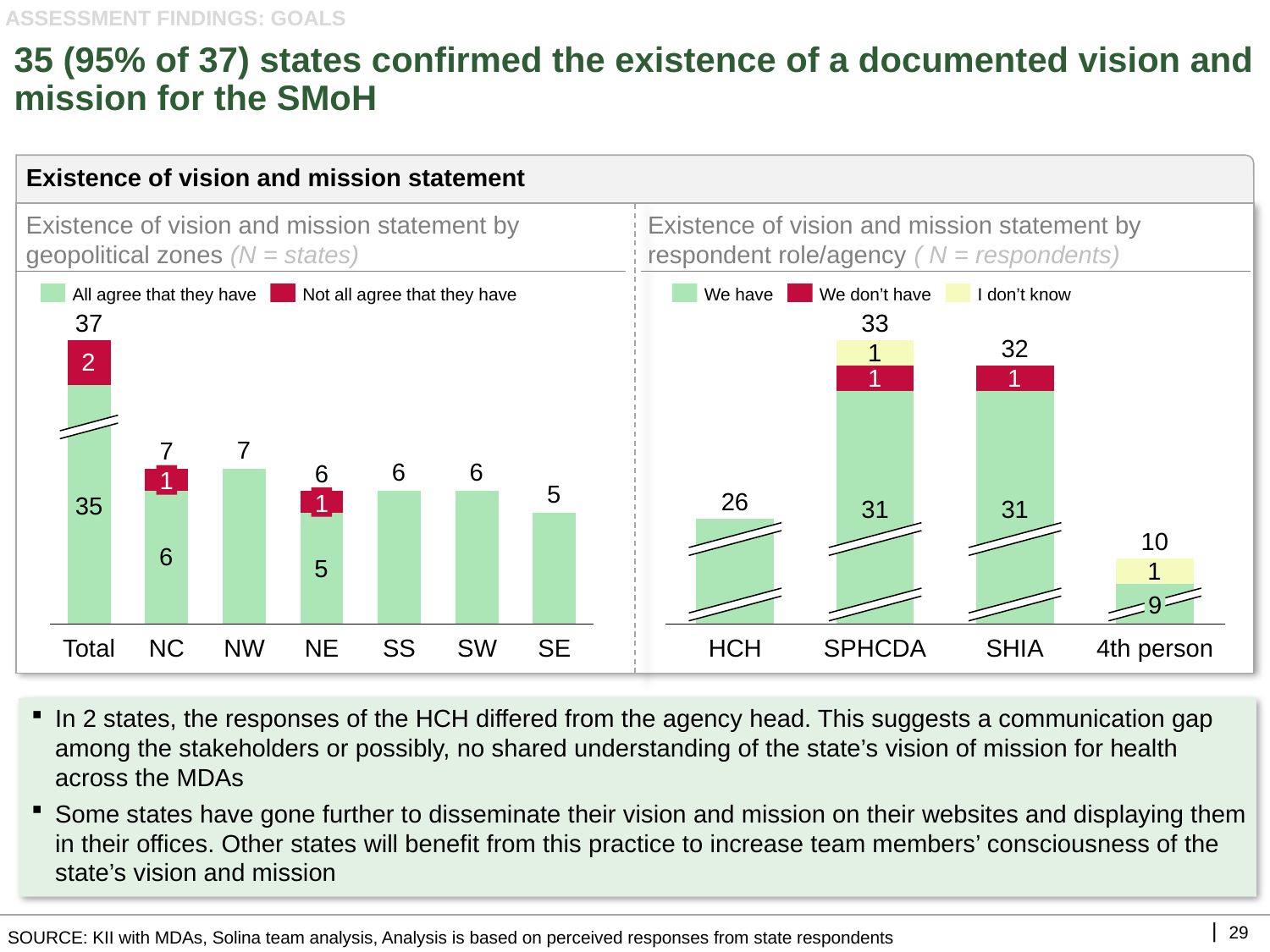
In the chart by geopolitical zones, what is the total value for the Total bar? 37 In the chart by respondent role/agency, which category has the lowest total? 4th person In the chart by respondent role/agency, how many categories are shown on the x axis? 4 In the chart by respondent role/agency, what is the 'We have' value for SHIA? 31 In the chart by geopolitical zones, what is the 'All agree that they have' value for NE? 5 In the chart by respondent role/agency, what is the total value for SPHCDA? 33 In the chart by geopolitical zones, which zone (excluding Total) has the lowest total? SE In the chart by respondent role/agency, which category has the highest total? SPHCDA In the chart by geopolitical zones, what is the 'Not all agree that they have' value for NC? 1 What kind of chart is the chart by respondent role/agency? Stacked bar chart In the chart by geopolitical zones, how many series does the legend list? 2 In the chart by geopolitical zones, what is the difference between the totals for NW and SE? 2